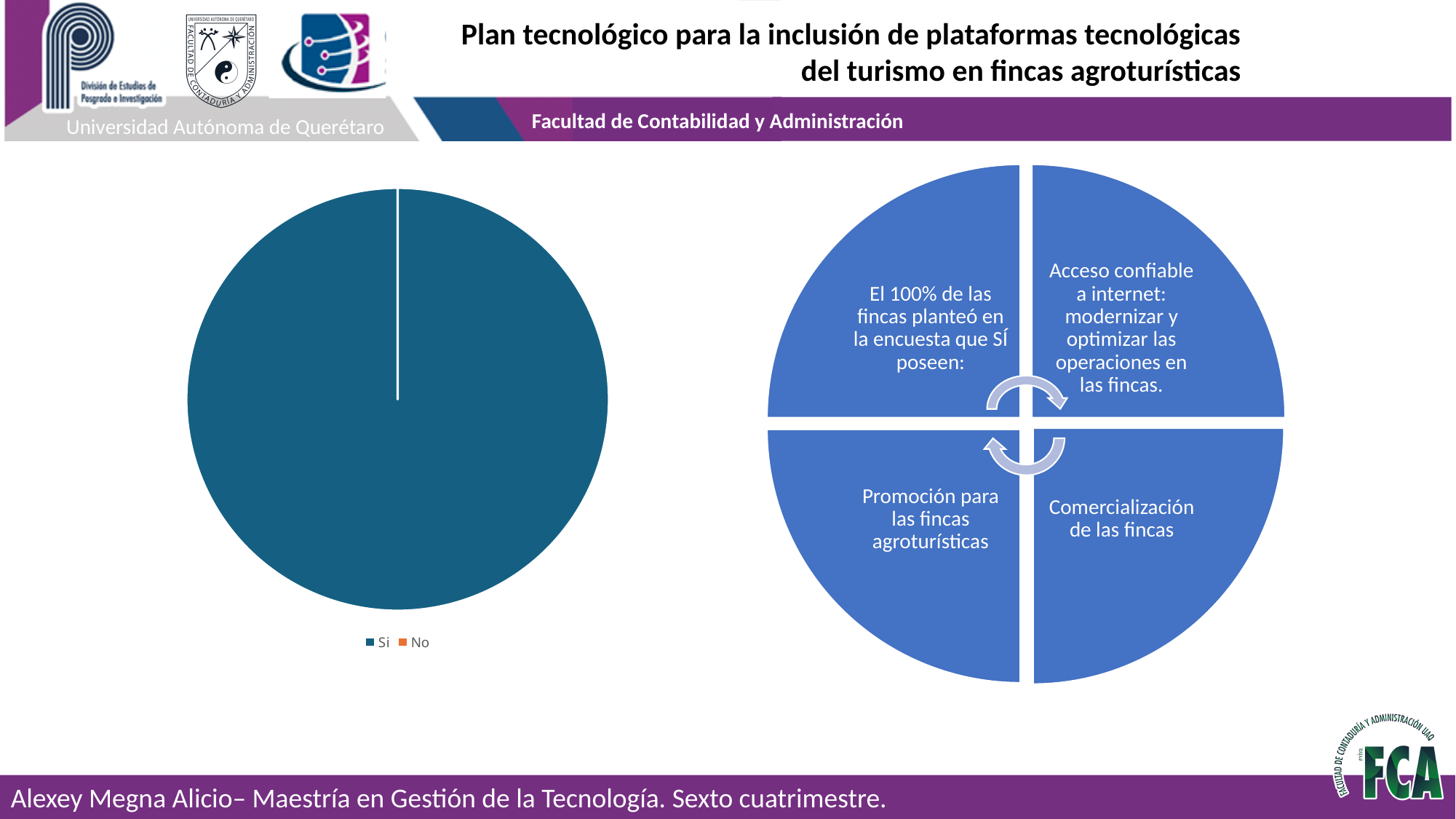
What kind of chart is shown on the left of the slide? pie chart Which category has the largest slice in the pie chart? Si What colour is used for the 'No' entry in the pie chart legend? orange Does the 'No' category occupy a visible slice of the pie chart? No Which category has the smallest slice in the pie chart? No How many entries does the legend of the pie chart list? 2 Which category has the larger slice in the pie chart, Si or No? Si What are the two legend entries of the pie chart? Si and No